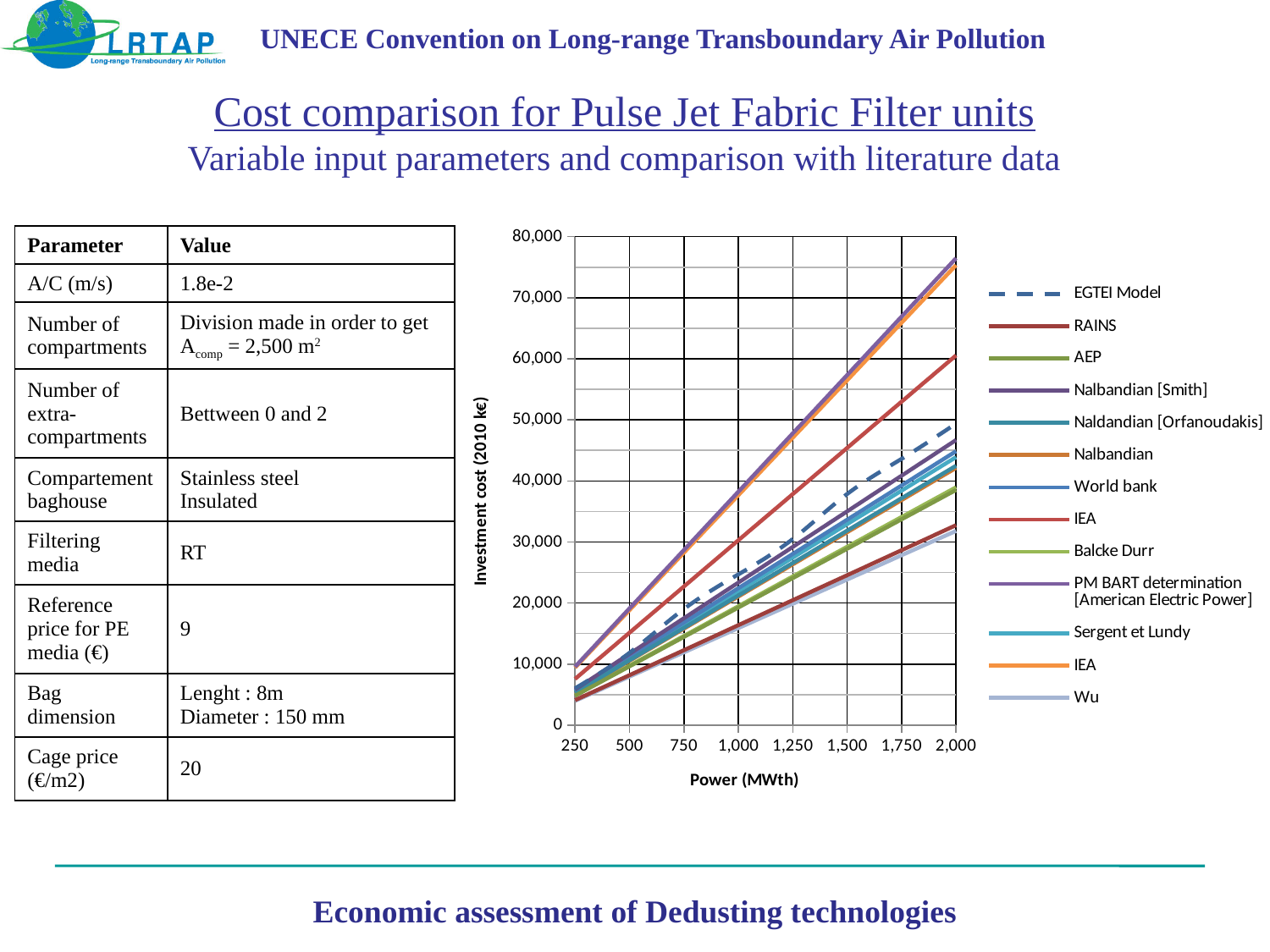
At 2,000 MWth, which has the higher investment cost, the Nalbandian series or the RAINS series? Nalbandian What is the label of the y axis of the chart? Investment cost (2010 k€) What is the highest value shown on the y axis of the chart? 80,000 Do the investment cost values rise or fall as power increases along the x axis? rise Is the investment cost for the Wu series at 2,000 MWth greater or less than 40,000? less Is the investment cost for the EGTEI Model at 1,000 MWth greater or less than 20,000? greater Is the investment cost for the EGTEI Model at 2,000 MWth greater or less than 40,000? greater How many series does the chart legend list? 13 What is the label of the x axis of the chart? Power (MWth) What kind of chart is shown on the slide? line chart